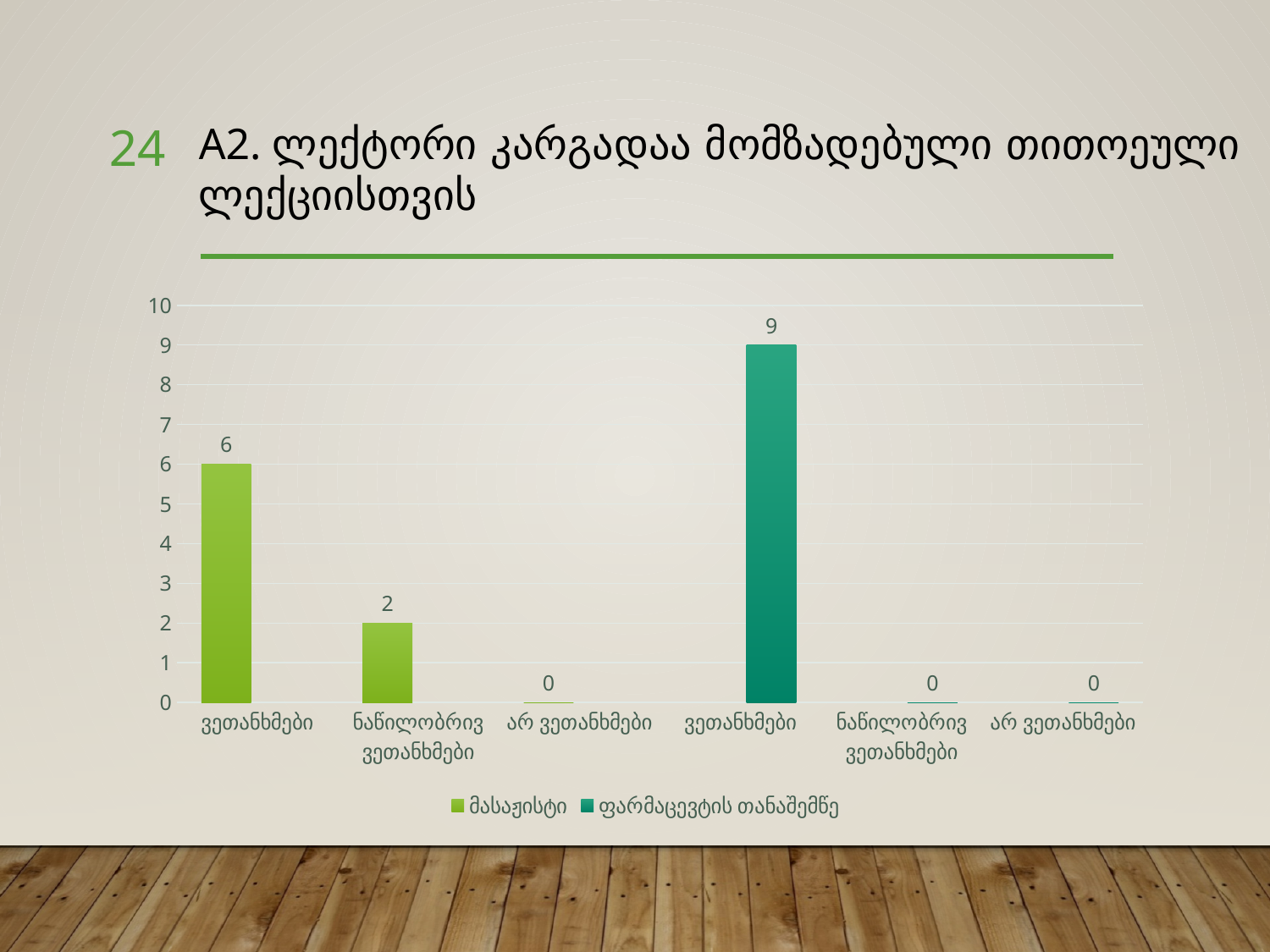
What is the highest value shown on the vertical axis? 10 What is the value of the არ ვეთანხმები bar for ფარმაცევტის თანაშემწე? 0 What is the value of the ვეთანხმები bar for მასაჟისტი (the light green group)? 6 What is the difference between the ვეთანხმები value for ფარმაცევტის თანაშემწე and the ვეთანხმები value for მასაჟისტი? 3 How many bars (categories) are shown along the x axis? 6 How many series does the legend list? 2 What is the value of the ნაწილობრივ ვეთანხმები bar for მასაჟისტი? 2 Which bar has the highest value on the chart? ვეთანხმები for ფარმაცევტის თანაშემწე Which is larger: the ვეთანხმები value for მასაჟისტი or the ვეთანხმები value for ფარმაცევტის თანაშემწე? ფარმაცევტის თანაშემწე What kind of chart is shown on the slide? bar chart What is the difference between the ვეთანხმები and ნაწილობრივ ვეთანხმები values for მასაჟისტი? 4 What is the value of the ვეთანხმები bar for ფარმაცევტის თანაშემწე (the dark green group)? 9